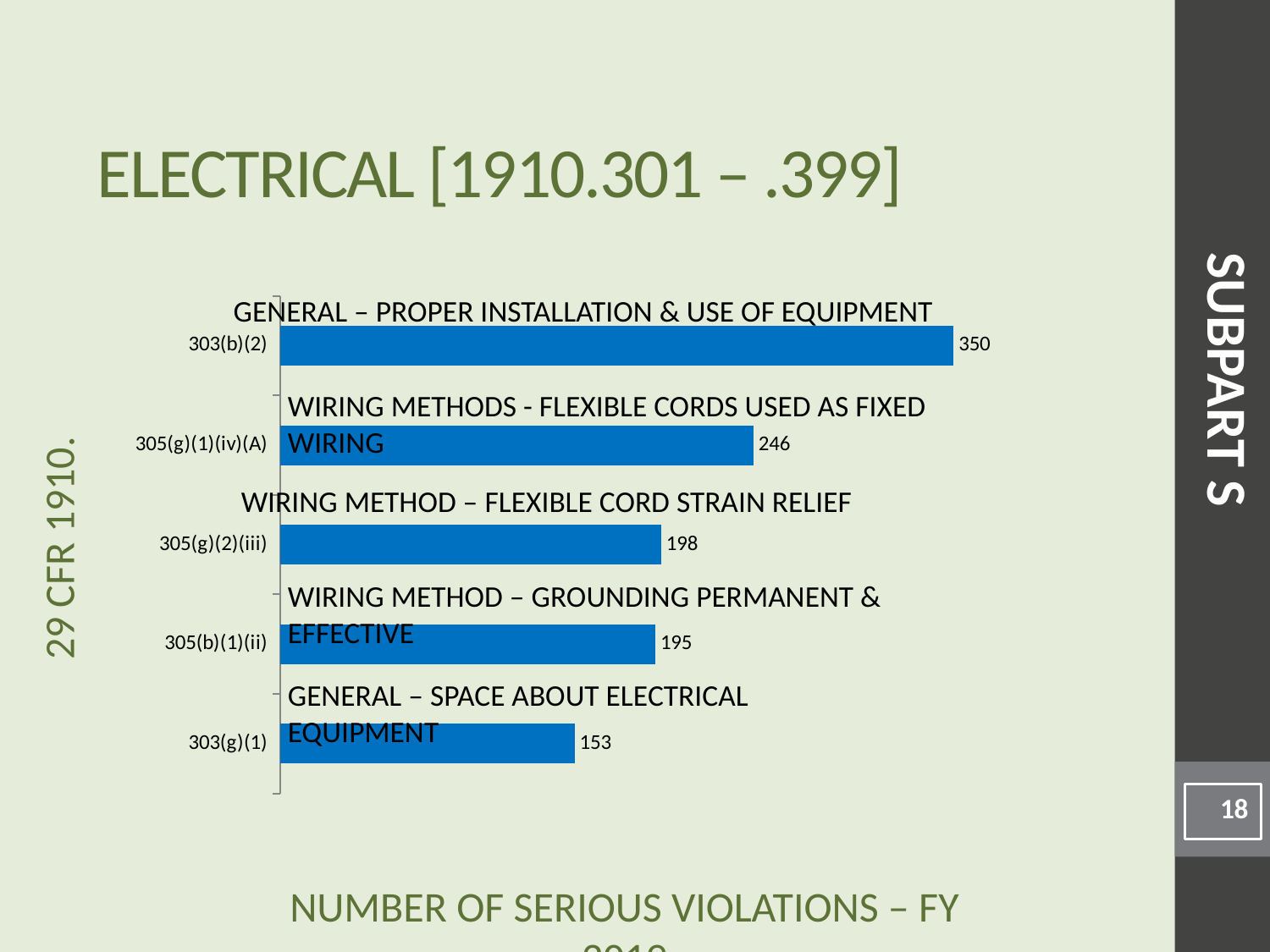
What is the number of serious violations for 305(b)(1)(ii)? 195 What is the difference between the values for 305(g)(1)(iv)(A) and 305(g)(2)(iii)? 48 What is the number of serious violations for 303(g)(1)? 153 What is the number of serious violations for 305(g)(1)(iv)(A)? 246 Which category has the lowest number of serious violations? 303(g)(1) How many categories are shown in the chart? 5 What is the number of serious violations for 305(g)(2)(iii)? 198 Which has a larger value, 305(g)(1)(iv)(A) or 305(b)(1)(ii)? 305(g)(1)(iv)(A) What kind of chart is shown on the slide? Bar chart What is the difference between the values for 303(b)(2) and 303(g)(1)? 197 Which category has the highest number of serious violations? 303(b)(2) What is the number of serious violations for 303(b)(2)? 350